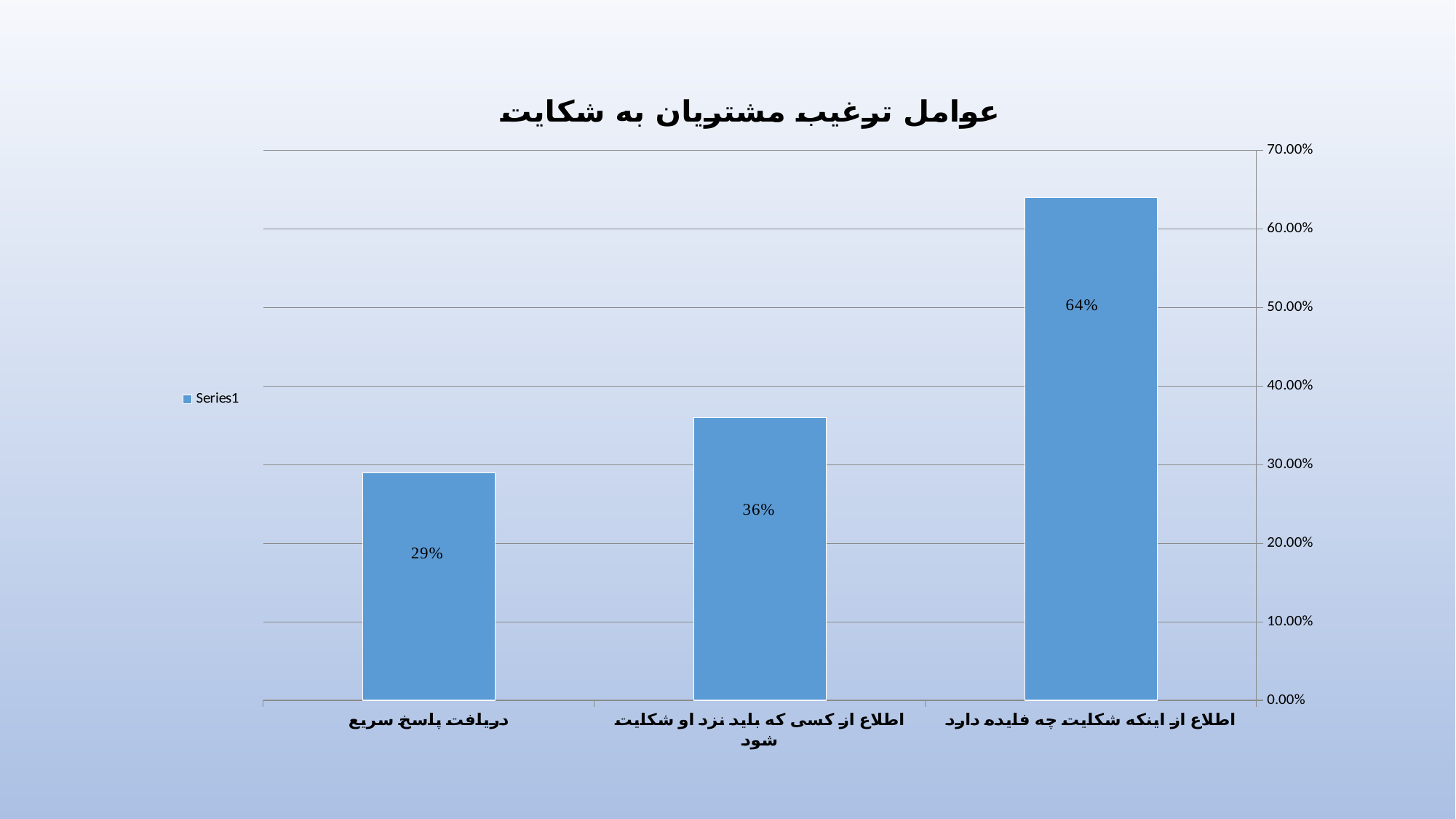
What value is shown for the category "دریافت پاسخ سریع"? 29% Which category has the lowest value? دریافت پاسخ سریع What value is shown for the category "اطلاع از کسی که باید نزد او شکایت شود"? 36% How many categories are shown on the x axis? 3 What is the difference between the values for "اطلاع از اینکه شکایت چه فایده دارد" and "دریافت پاسخ سریع"? 35% Which category has the highest value? اطلاع از اینکه شکایت چه فایده دارد Is the value for "اطلاع از اینکه شکایت چه فایده دارد" greater or less than 60.00%? greater What kind of chart is shown on the slide? bar chart What is the difference between the values for "اطلاع از کسی که باید نزد او شکایت شود" and "دریافت پاسخ سریع"? 7% Which is larger: the value for "اطلاع از کسی که باید نزد او شکایت شود" or the value for "دریافت پاسخ سریع"? اطلاع از کسی که باید نزد او شکایت شود How many series does the legend list? 1 What value is shown for the category "اطلاع از اینکه شکایت چه فایده دارد"? 64%